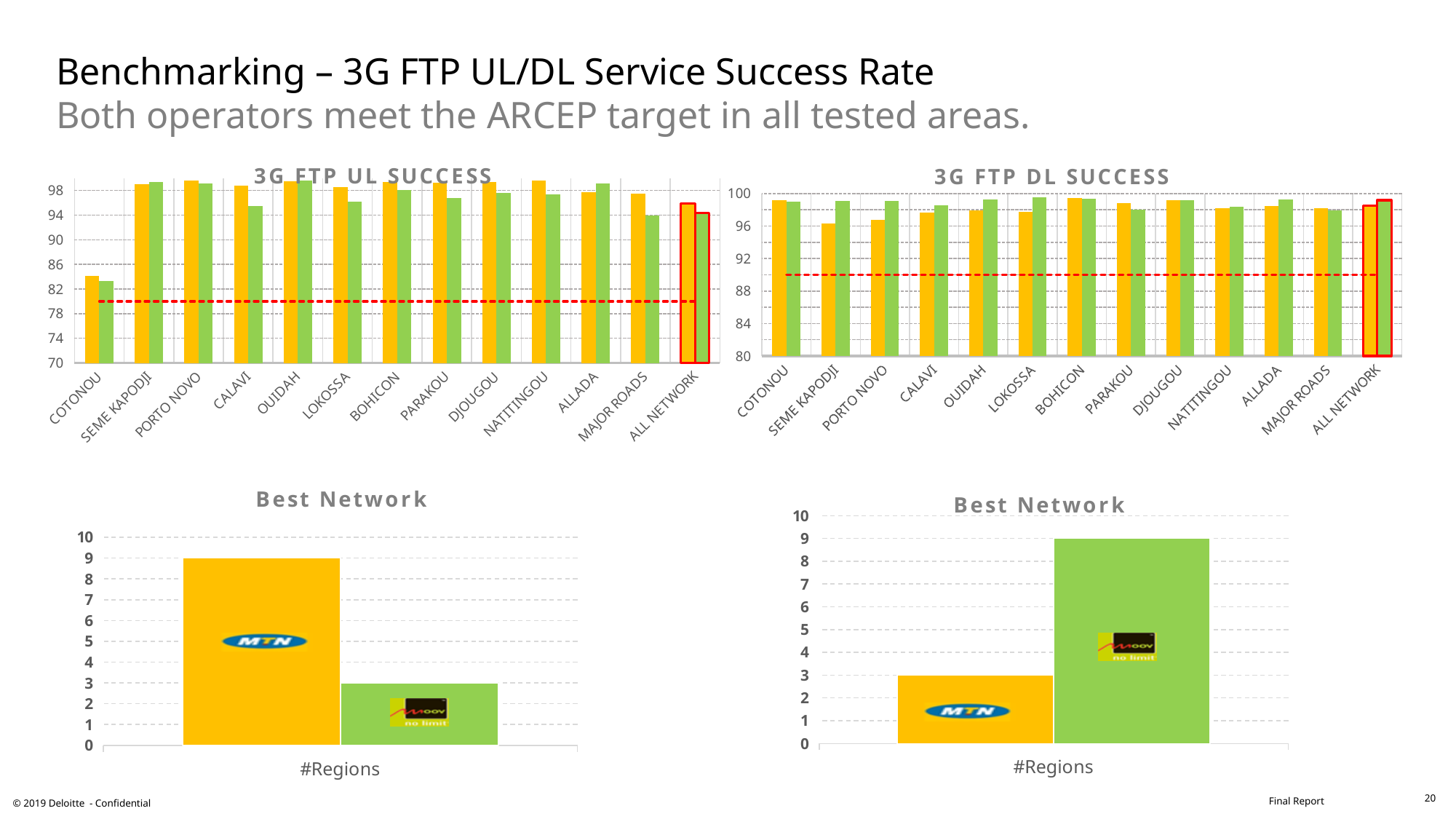
In the '3G FTP UL SUCCESS' chart, is the yellow bar for COTONOU greater or less than 90? less What kind of chart is the '3G FTP UL SUCCESS' chart? bar chart In the bottom-left 'Best Network' chart, what is the value of the MTN bar? 9 In the bottom-right 'Best Network' chart, which operator has the higher bar? Moov In the bottom-right 'Best Network' chart, what is the value of the MTN bar? 3 In the '3G FTP UL SUCCESS' chart, which category has the lowest values for both bars? COTONOU In the '3G FTP DL SUCCESS' chart, is the yellow bar for SEME KAPODJI greater or less than 98? less In the bottom-left 'Best Network' chart, what is the difference between the MTN bar and the Moov bar? 6 In the '3G FTP DL SUCCESS' chart, is the green bar for BOHICON greater or less than 96? greater How many categories are shown on the x axis of the '3G FTP UL SUCCESS' chart? 13